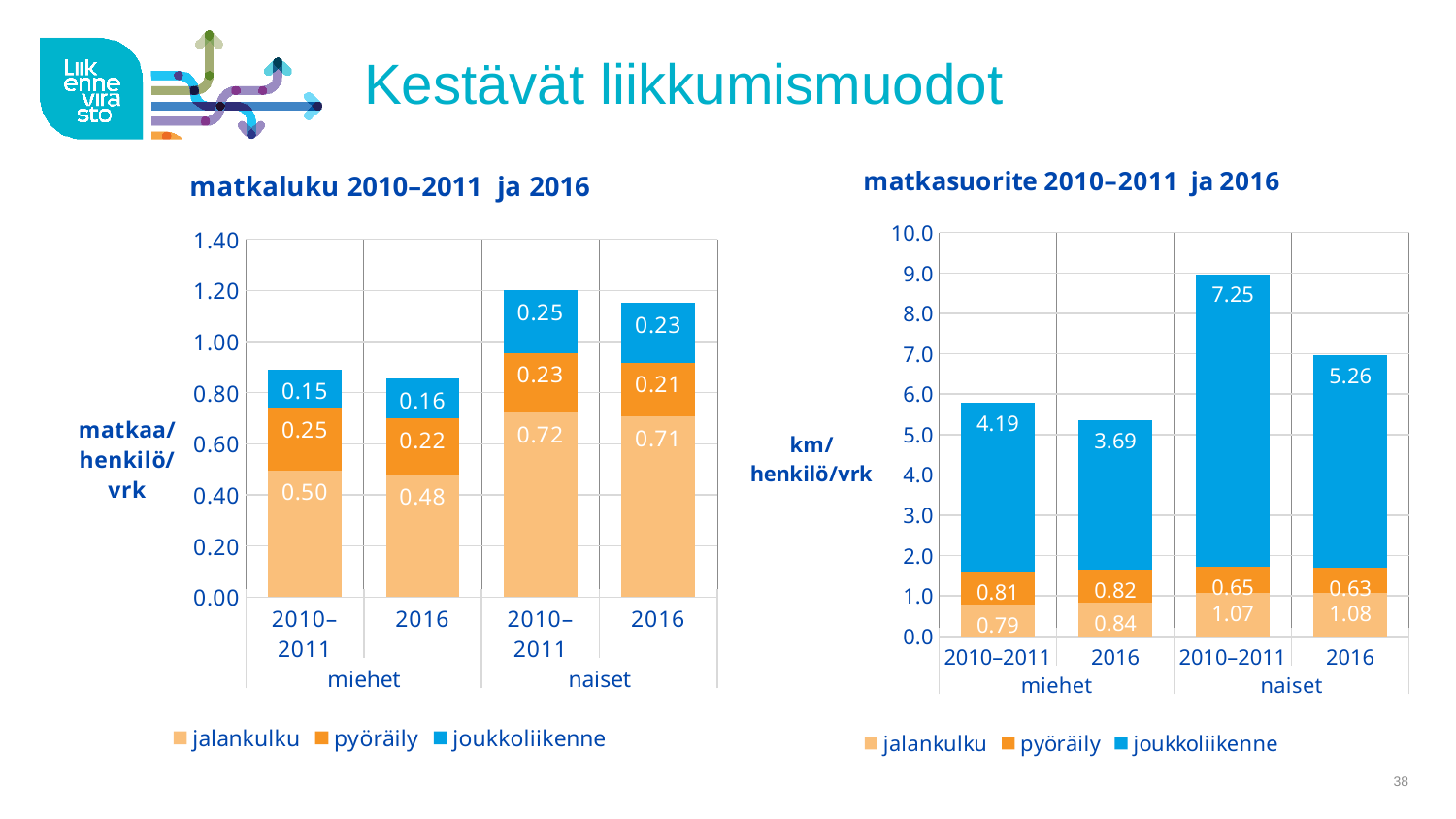
In the chart titled 'matkasuorite 2010–2011 ja 2016', which bar has the lowest joukkoliikenne value? miehet 2016 In the chart titled 'matkasuorite 2010–2011 ja 2016', what is the total of the stacked bar for miehet in 2010–2011? 5.79 What kind of chart is the chart titled 'matkasuorite 2010–2011 ja 2016'? stacked bar chart In the chart titled 'matkasuorite 2010–2011 ja 2016', is the joukkoliikenne value for miehet in 2010–2011 larger or smaller than for miehet in 2016? larger In the chart titled 'matkaluku 2010–2011 ja 2016', what is the difference between the pyöräily values for miehet in 2010–2011 and 2016? 0.03 In the chart titled 'matkasuorite 2010–2011 ja 2016', which bar has the highest joukkoliikenne value? naiset 2010–2011 In the chart titled 'matkaluku 2010–2011 ja 2016', what is the total of the stacked bar for naiset in 2010–2011? 1.20 In the chart titled 'matkaluku 2010–2011 ja 2016', what is the jalankulku value for miehet in 2010–2011? 0.50 In the chart titled 'matkasuorite 2010–2011 ja 2016', what is the jalankulku value for miehet in 2016? 0.84 In the chart titled 'matkasuorite 2010–2011 ja 2016', what is the joukkoliikenne value for naiset in 2010–2011? 7.25 In the chart titled 'matkaluku 2010–2011 ja 2016', how many series does the legend list? 3 In the chart titled 'matkaluku 2010–2011 ja 2016', what is the joukkoliikenne value for naiset in 2016? 0.23